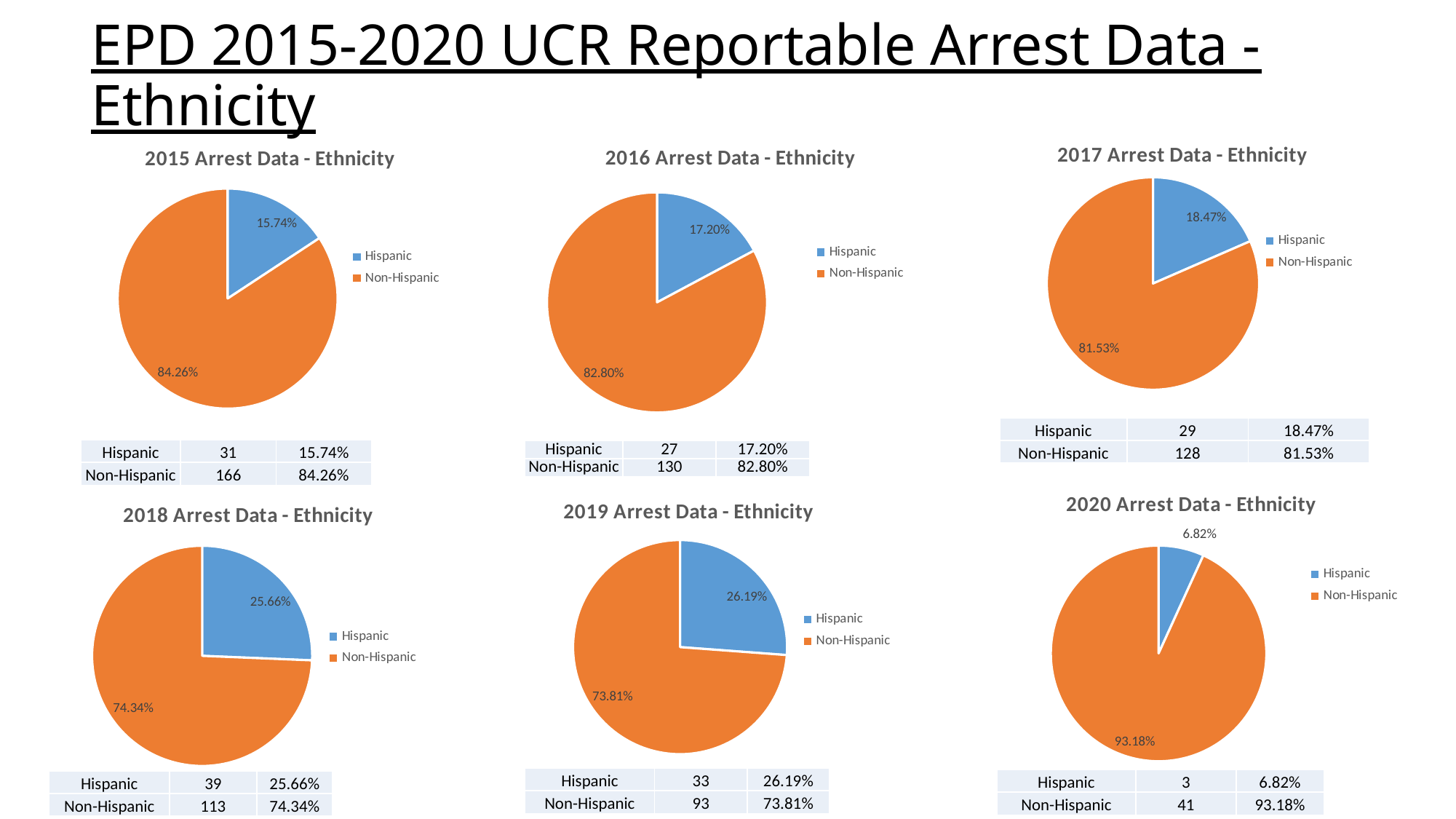
In the '2017 Arrest Data - Ethnicity' chart, what percentage is shown for the Hispanic slice? 18.47% How many slices does the '2017 Arrest Data - Ethnicity' pie chart have? 2 Is the Hispanic share larger in the '2019 Arrest Data - Ethnicity' chart or the '2020 Arrest Data - Ethnicity' chart? 2019 Arrest Data - Ethnicity In the '2018 Arrest Data - Ethnicity' chart, what is the difference in percentage points between the Non-Hispanic and Hispanic slices? 48.68 In the '2015 Arrest Data - Ethnicity' chart, what percentage is shown for the Hispanic slice? 15.74% In the '2019 Arrest Data - Ethnicity' chart, which slice is the largest? Non-Hispanic In the '2020 Arrest Data - Ethnicity' chart, what colour is the Non-Hispanic slice? Orange In the '2018 Arrest Data - Ethnicity' chart, which slice is the smallest? Hispanic What type of chart is the '2015 Arrest Data - Ethnicity' chart? Pie chart In the '2016 Arrest Data - Ethnicity' chart, what percentage is shown for the Non-Hispanic slice? 82.80% How many entries does the legend of the '2016 Arrest Data - Ethnicity' chart list? 2 In the '2020 Arrest Data - Ethnicity' chart, what percentage is shown for the Hispanic slice? 6.82%